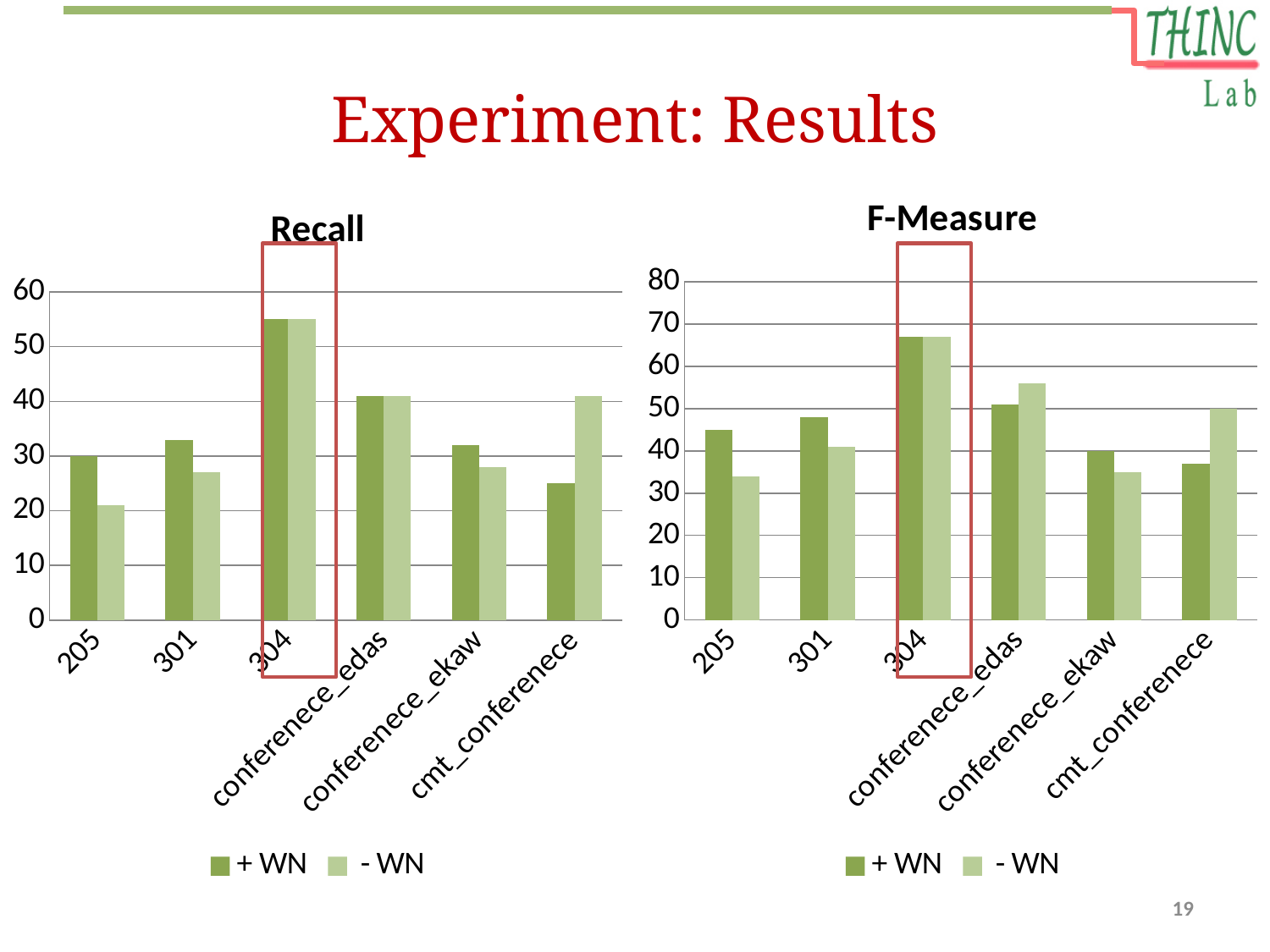
In the F-Measure chart, is the - WN value for 205 greater or less than 40? less How many categories are shown on the x axis of the Recall chart? 6 In the F-Measure chart, for conferenece_edas, which series has the larger value, + WN or - WN? - WN In the Recall chart, for cmt_conferenece, which series has the larger value, + WN or - WN? - WN In the F-Measure chart, which category has the highest + WN value? 304 In the Recall chart, which category has the lowest - WN value? 205 Which category is highlighted with a red box in both charts? 304 In the F-Measure chart, is the - WN value for 304 greater or less than 60? greater How many series does the legend of the Recall chart list? 2 In the Recall chart, is the + WN value for 304 greater or less than 50? greater What kind of chart is the Recall chart? bar chart In the Recall chart, which category has the highest + WN value? 304